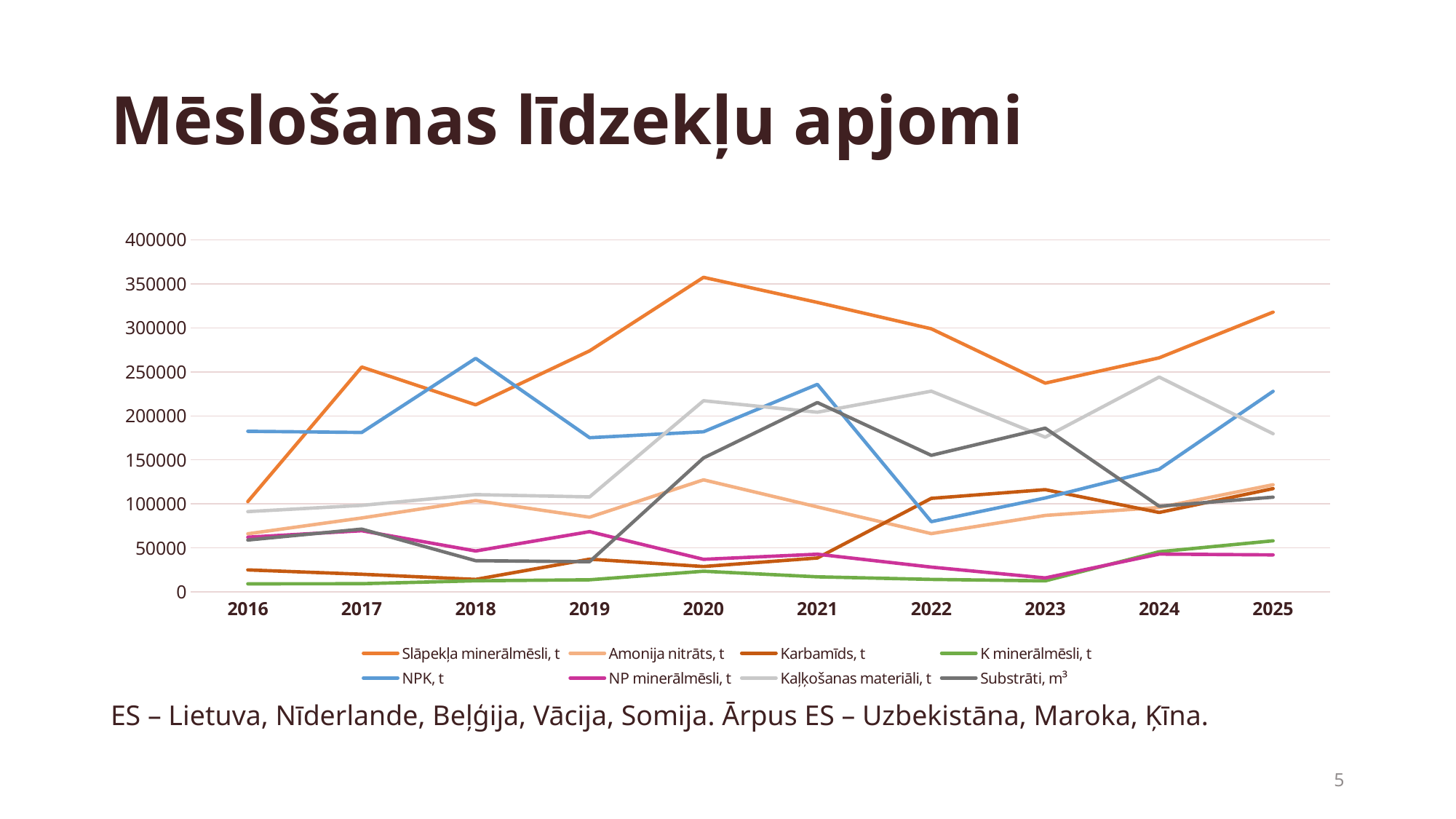
Is the value for 'Slāpekļa minerālmēsli, t' in 2020 greater or less than 300000? greater Is the value for 'Kaļķošanas materiāli, t' in 2024 greater or less than 200000? greater Is the value for 'NPK, t' in 2022 greater or less than 100000? less In 2018, which is larger: 'NPK, t' or 'Slāpekļa minerālmēsli, t'? NPK, t What kind of chart is shown on the slide? Line chart In which year does the series 'Slāpekļa minerālmēsli, t' reach its highest value? 2020 Which series has the highest value in 2025? Slāpekļa minerālmēsli, t Does the series 'K minerālmēsli, t' rise or fall from 2023 to 2025? rise Which series has the lowest value in 2016? K minerālmēsli, t How many series does the chart legend list? 8 How many years are plotted along the x axis? 10